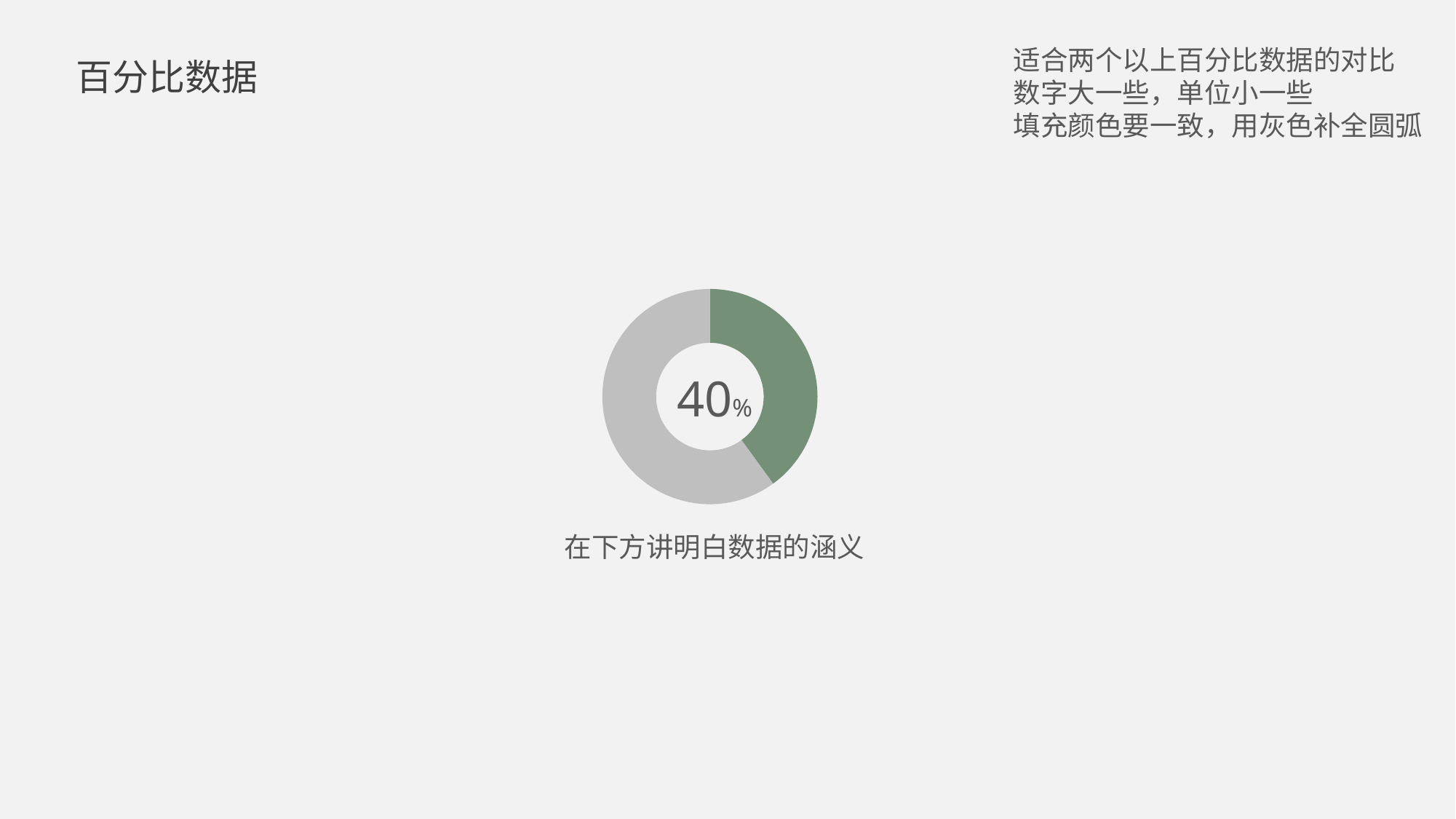
Which segment of the donut chart is larger, the green one or the grey one? The grey one How many segments does the donut chart have? 2 What share of the donut chart does the grey segment represent? 60% What share of the donut chart does the green segment represent? 40% What kind of chart is shown on the slide? Donut (pie) chart What colour is the segment representing 40% in the donut chart? Green What is the title of the slide containing the donut chart? 百分比数据 Is the green segment of the donut chart greater or less than 50%? less What percentage is printed in the centre of the donut chart? 40%